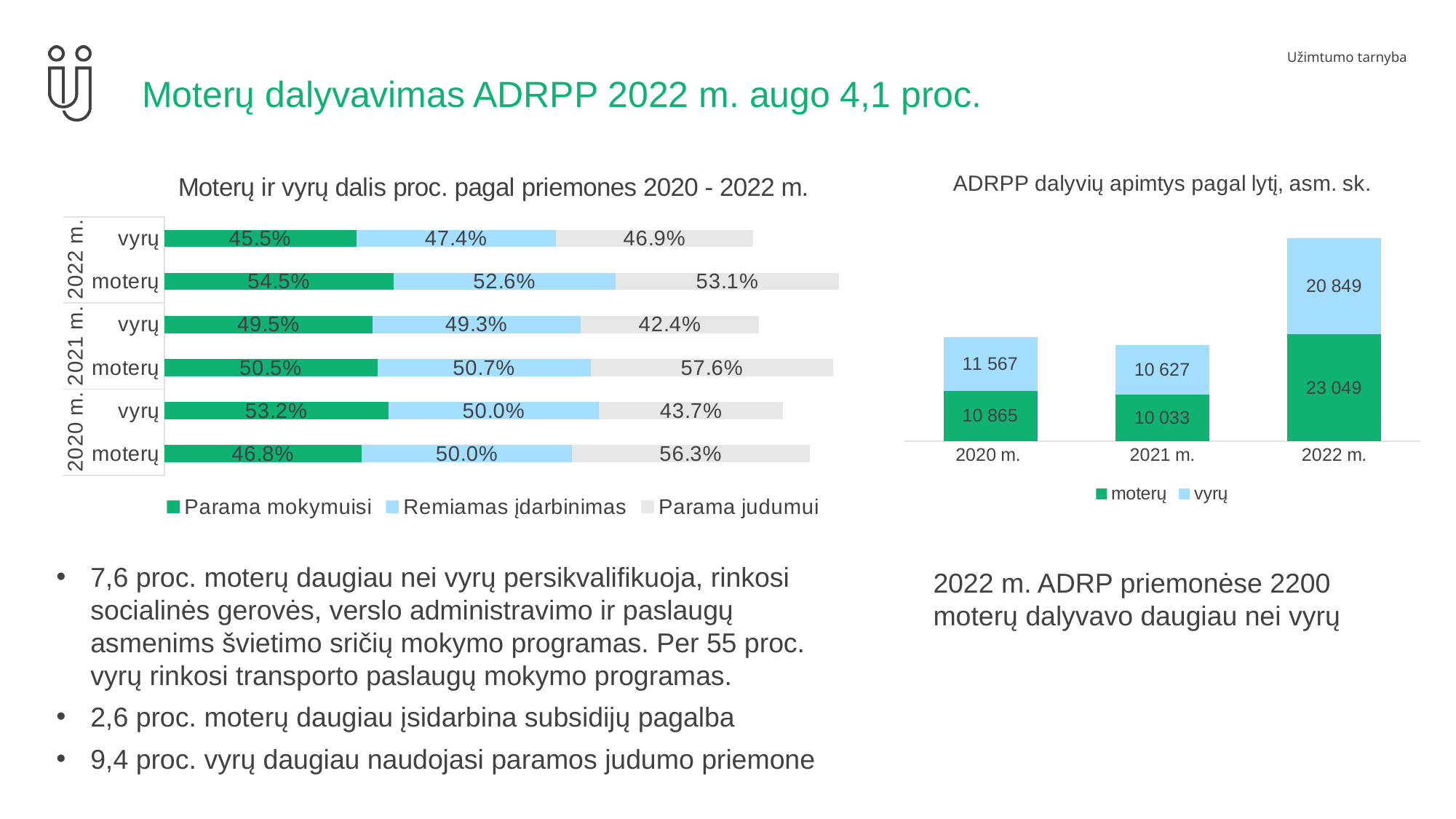
In the chart 'Moterų ir vyrų dalis proc. pagal priemones 2020 - 2022 m.', what is the Parama judumui share for vyrų in 2020 m.? 43.7% In the chart 'ADRPP dalyvių apimtys pagal lytį, asm. sk.', how many series does the legend list? 2 In the chart 'ADRPP dalyvių apimtys pagal lytį, asm. sk.', what is the total of the stacked bar for 2021 m.? 20 660 What type of chart is 'Moterų ir vyrų dalis proc. pagal priemones 2020 - 2022 m.'? Stacked bar chart In the chart 'Moterų ir vyrų dalis proc. pagal priemones 2020 - 2022 m.', what is the Parama mokymuisi share for moterų in 2022 m.? 54.5% In the chart 'Moterų ir vyrų dalis proc. pagal priemones 2020 - 2022 m.', how many series does the legend list? 3 In the chart 'ADRPP dalyvių apimtys pagal lytį, asm. sk.', what is the value for moterų in 2022 m.? 23 049 In the chart 'Moterų ir vyrų dalis proc. pagal priemones 2020 - 2022 m.', which is larger: the Parama judumui share for moterų in 2021 m. or for vyrų in 2021 m.? moterų in 2021 m. In the chart 'Moterų ir vyrų dalis proc. pagal priemones 2020 - 2022 m.', what is the Remiamas įdarbinimas share for moterų in 2021 m.? 50.7% In the chart 'ADRPP dalyvių apimtys pagal lytį, asm. sk.', what is the value for vyrų in 2020 m.? 11 567 In the chart 'ADRPP dalyvių apimtys pagal lytį, asm. sk.', what is the difference between moterų and vyrų in 2022 m.? 2 200 In the chart 'ADRPP dalyvių apimtys pagal lytį, asm. sk.', which year has the highest total number of participants? 2022 m.